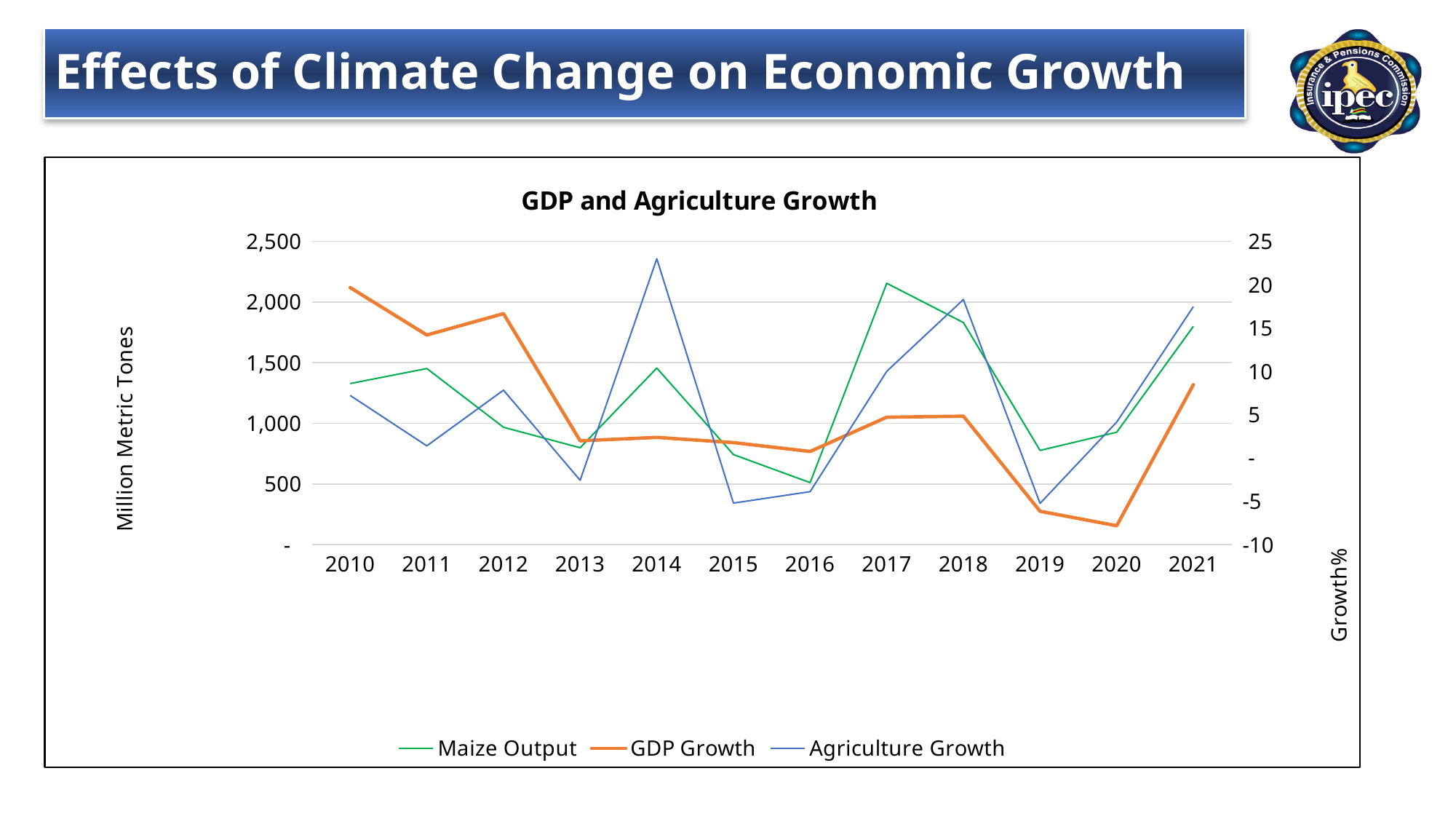
Does Maize Output rise or fall from 2018 to 2019? Fall What is the label of the left vertical axis? Million Metric Tones Is the Maize Output value for 2017 greater or less than 2,000? greater In which year is GDP Growth highest? 2010 What is the title of the chart? GDP and Agriculture Growth In which year is Maize Output highest? 2017 In which year is Agriculture Growth highest? 2014 What kind of chart is shown on the slide? Line chart How many years are plotted along the x axis? 12 How many series does the legend list? 3 In which year is Maize Output lowest? 2016 Is the GDP Growth value for 2020 greater or less than -5? less